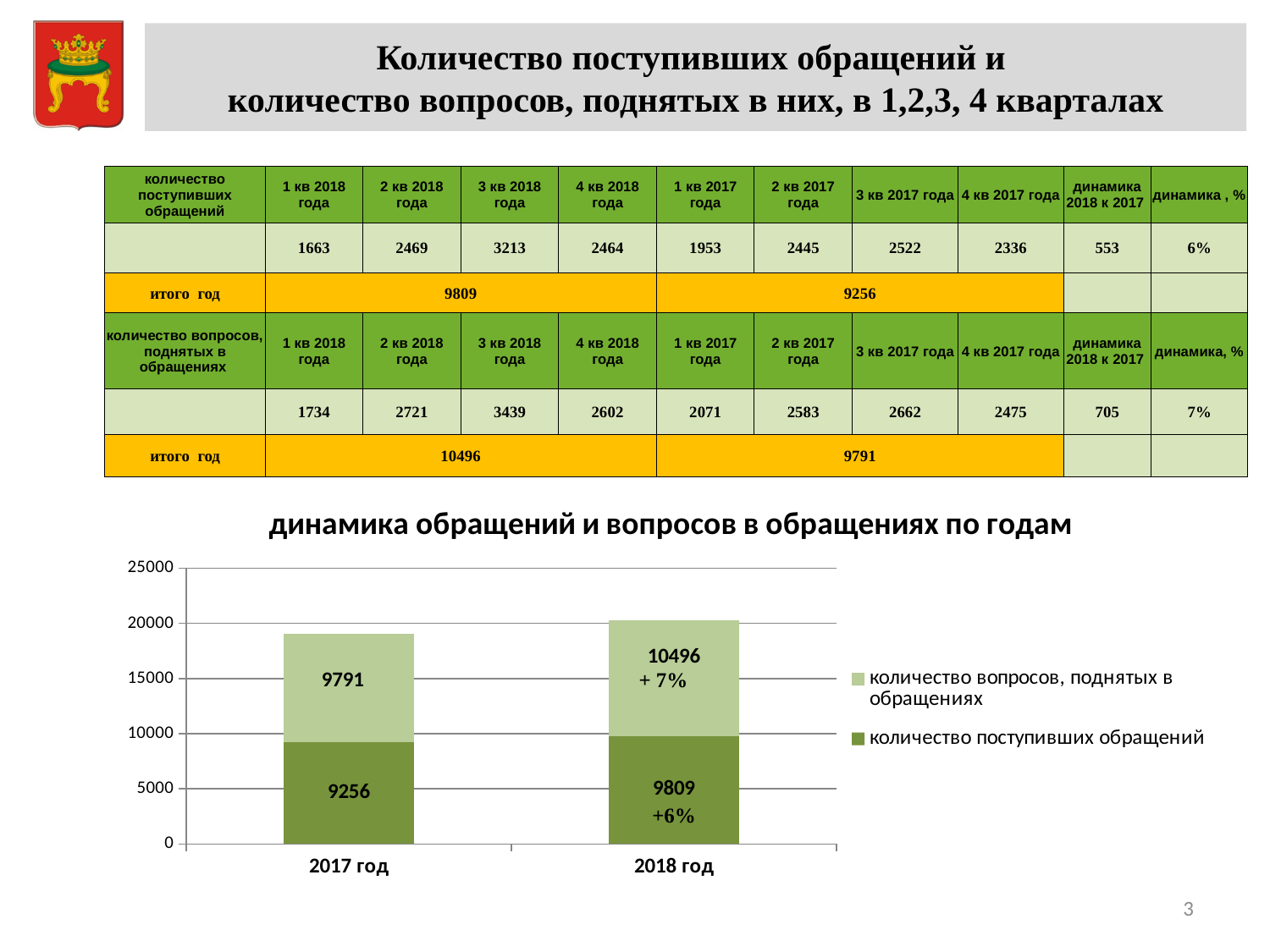
What is the value of 'количество поступивших обращений' for 2018 год? 9809 Does the total of the stacked bar rise or fall from 2017 год to 2018 год? rise What is the value of 'количество вопросов, поднятых в обращениях' for 2018 год? 10496 What is the difference between 'количество вопросов, поднятых в обращениях' in 2018 год and in 2017 год? 705 How many series does the chart legend list? 2 How many categories are shown on the x axis of the chart? 2 What is the value of 'количество вопросов, поднятых в обращениях' for 2017 год? 9791 What is the chart's title? динамика обращений и вопросов в обращениях по годам What is the value of 'количество поступивших обращений' for 2017 год? 9256 What type of chart is shown on the slide? stacked bar chart What is the total of the stacked bar for 2017 год? 19047 What is the total of the stacked bar for 2018 год? 20305